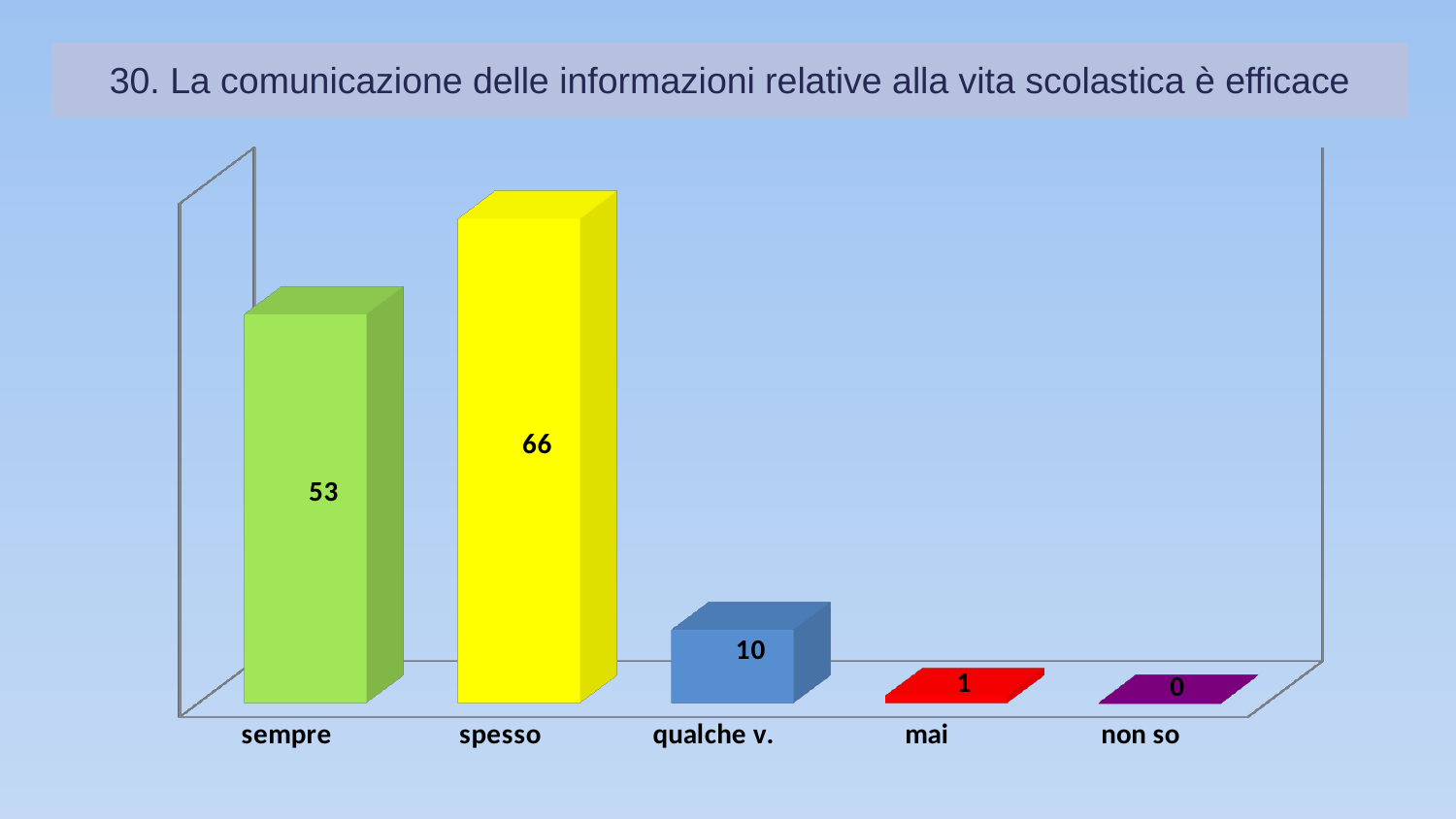
What is the value for "spesso"? 66 What is the value for "non so"? 0 What is the value for "sempre"? 53 Which category has the highest value? spesso What kind of chart is shown on the slide? bar chart Which is larger, the value for "sempre" or the value for "qualche v."? sempre How many categories are shown on the x axis? 5 What is the difference between the values for "spesso" and "sempre"? 13 What is the value for "mai"? 1 Which category has the lowest value? non so What is the value for "qualche v."? 10 What is the title of the slide? 30. La comunicazione delle informazioni relative alla vita scolastica è efficace